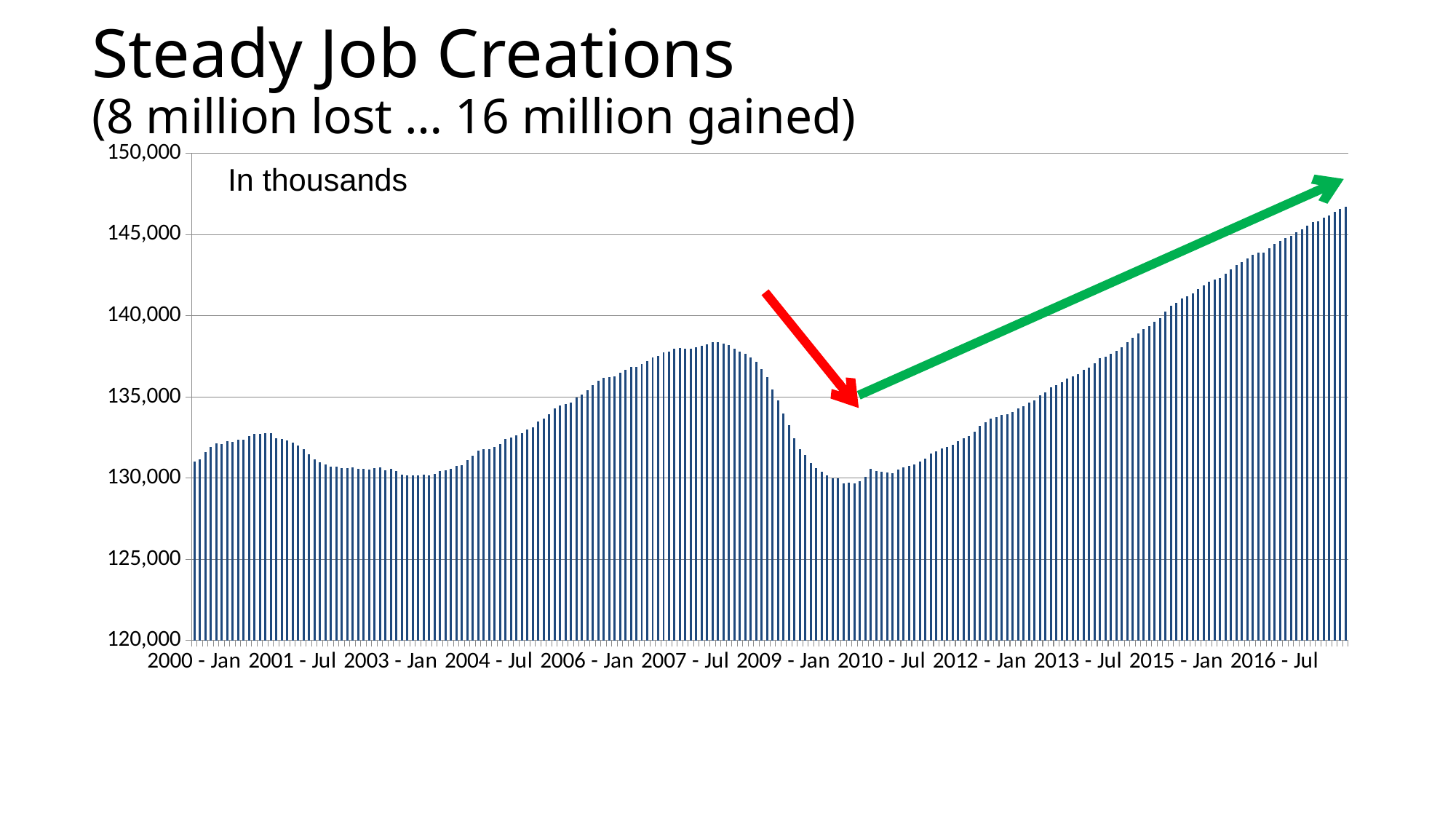
Is the value for 2012 - Jan greater or less than 135,000? less Is the value for 2000 - Jan greater or less than 130,000? greater Is the value for 2007 - Jul greater or less than 135,000? greater In what units are the chart's values expressed, according to the note inside the plot area? In thousands What is the title of the slide's chart? Steady Job Creations (8 million lost ... 16 million gained) Which is larger, the value for 2007 - Jul or the value for 2010 - Jul? 2007 - Jul Do the values rise or fall between 2010 - Jul and 2016 - Jul? rise Do the values rise or fall between 2007 - Jul and 2010 - Jul? fall How many date labels are shown along the x axis? 12 What kind of chart is shown on the slide? bar chart